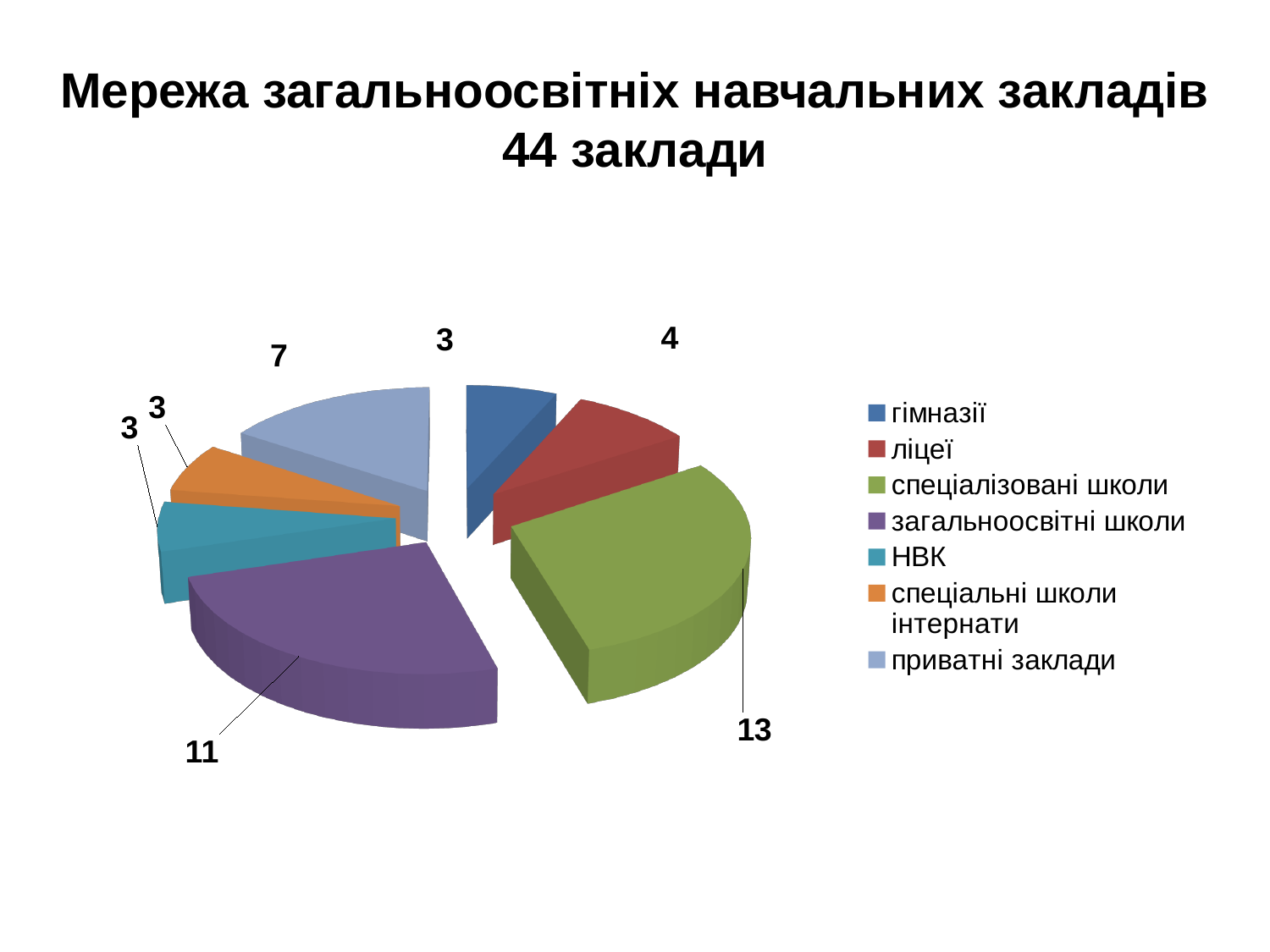
What share of the pie does загальноосвітні школи represent? 25% What is the value for спеціалізовані школи? 13 What is the value for приватні заклади? 7 What kind of chart is shown on the slide? pie chart What is the difference between the values for спеціалізовані школи and загальноосвітні школи? 2 How many slices does the pie chart have? 7 Which category has the largest slice of the pie? спеціалізовані школи What is the value for НВК? 3 What is the value for загальноосвітні школи? 11 What is the value for ліцеї? 4 Which is larger, the value for приватні заклади or the value for ліцеї? приватні заклади What is the title of the chart? Мережа загальноосвітніх навчальних закладів 44 заклади